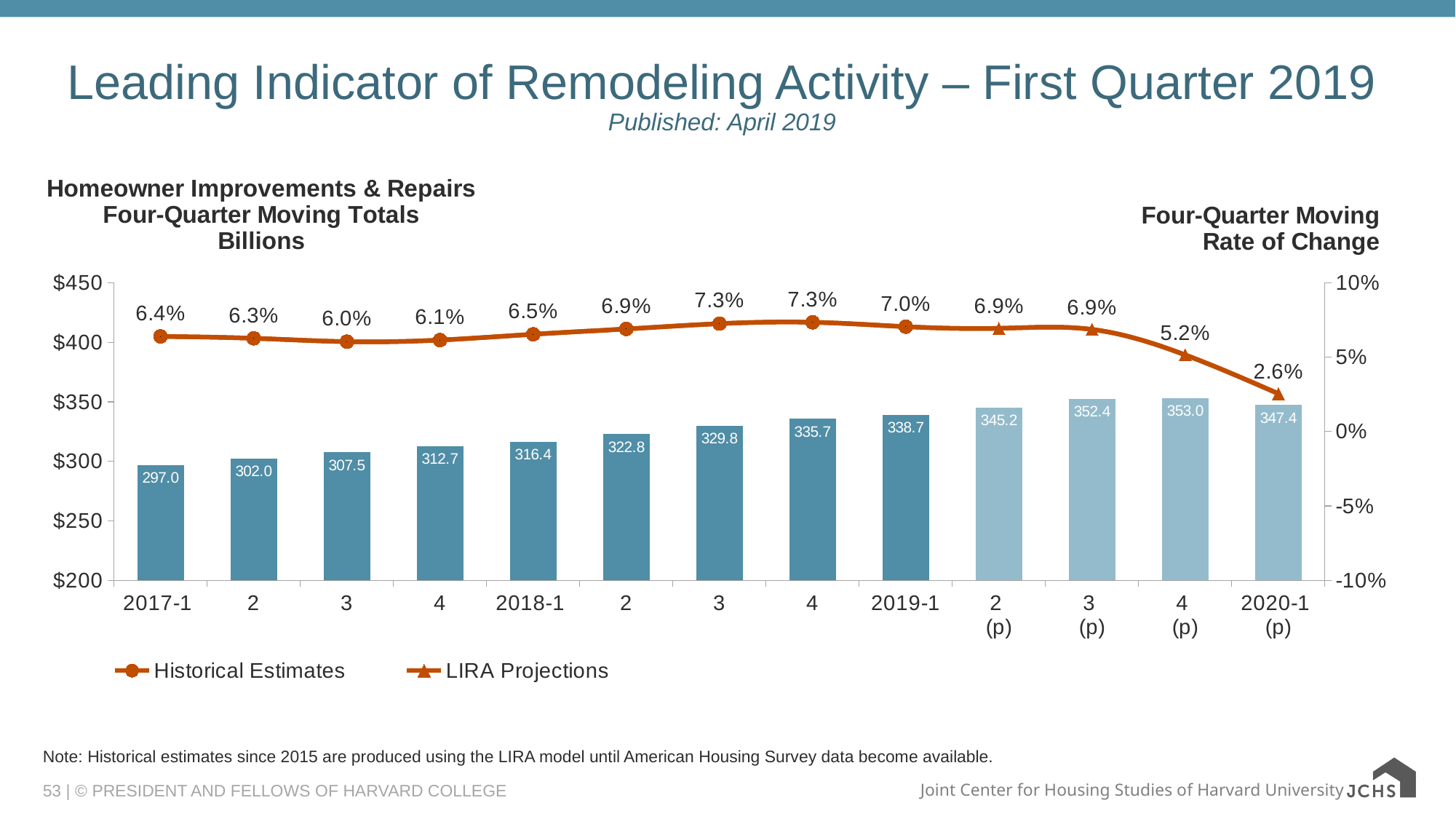
How many series does the legend list? 2 Which quarter has the lowest four-quarter moving rate of change? 2020-1 (p) What is the difference between the four-quarter moving totals for 2019-1 and 2017-1? 41.7 Which quarter has the highest four-quarter moving total? 4 (p) of 2019 What is the projected rate of change for 2019-4 (p)? 5.2% What is the projected four-quarter moving total for 2020-1 (p)? 347.4 Do the four-quarter moving totals rise or fall from 2017-1 to 2019-1? rise What is the four-quarter moving rate of change for 2018-3? 7.3% Which quarter has the lowest four-quarter moving total? 2017-1 What is the four-quarter moving total for 2019-1? 338.7 Is the four-quarter moving total for 2018-2 greater or less than 2017-4? greater How many quarters are shown on the x axis? 13